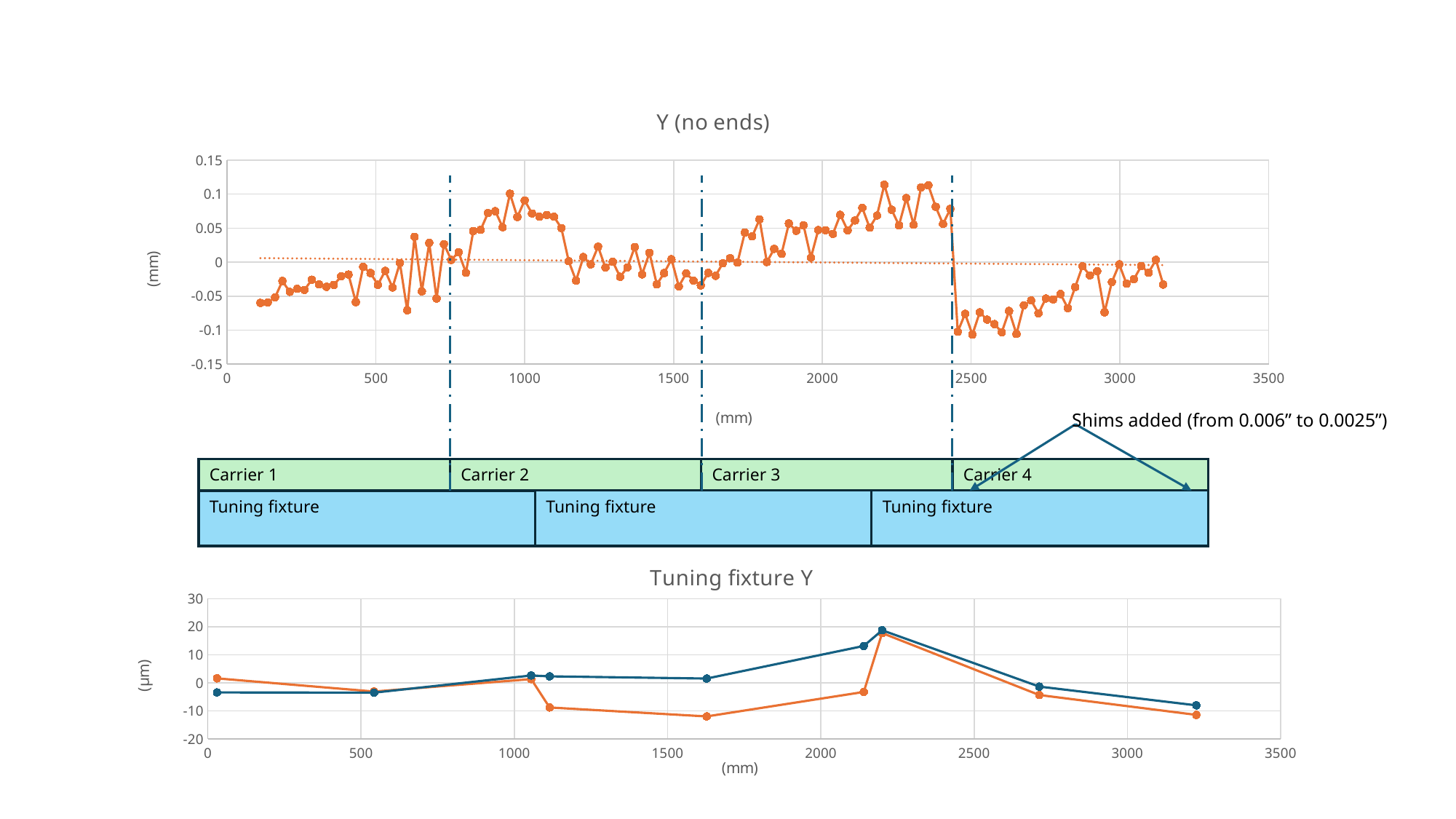
In the bottom chart "Tuning fixture Y", do the values of both series rise or fall between about x = 2200 mm and x = 3230 mm? fall In the top chart "Y (no ends)", do the values rise or fall between about x = 2500 mm and x = 3000 mm? rise In the top chart "Y (no ends)", is the value at about x = 100 mm greater or less than 0? less In the top chart "Y (no ends)", is the value at about x = 2600 mm greater or less than -0.05? less What kind of chart is the bottom chart titled "Tuning fixture Y"? line chart In the bottom chart "Tuning fixture Y", at about x = 1630 mm, which series has the larger value, blue or orange? blue In the bottom chart "Tuning fixture Y", how many data points does the blue series have? 9 In the bottom chart "Tuning fixture Y", is the peak value of the blue series greater or less than 10? greater What unit is shown on the vertical axis of the bottom chart "Tuning fixture Y"? (µm) What is the title of the top chart? Y (no ends)